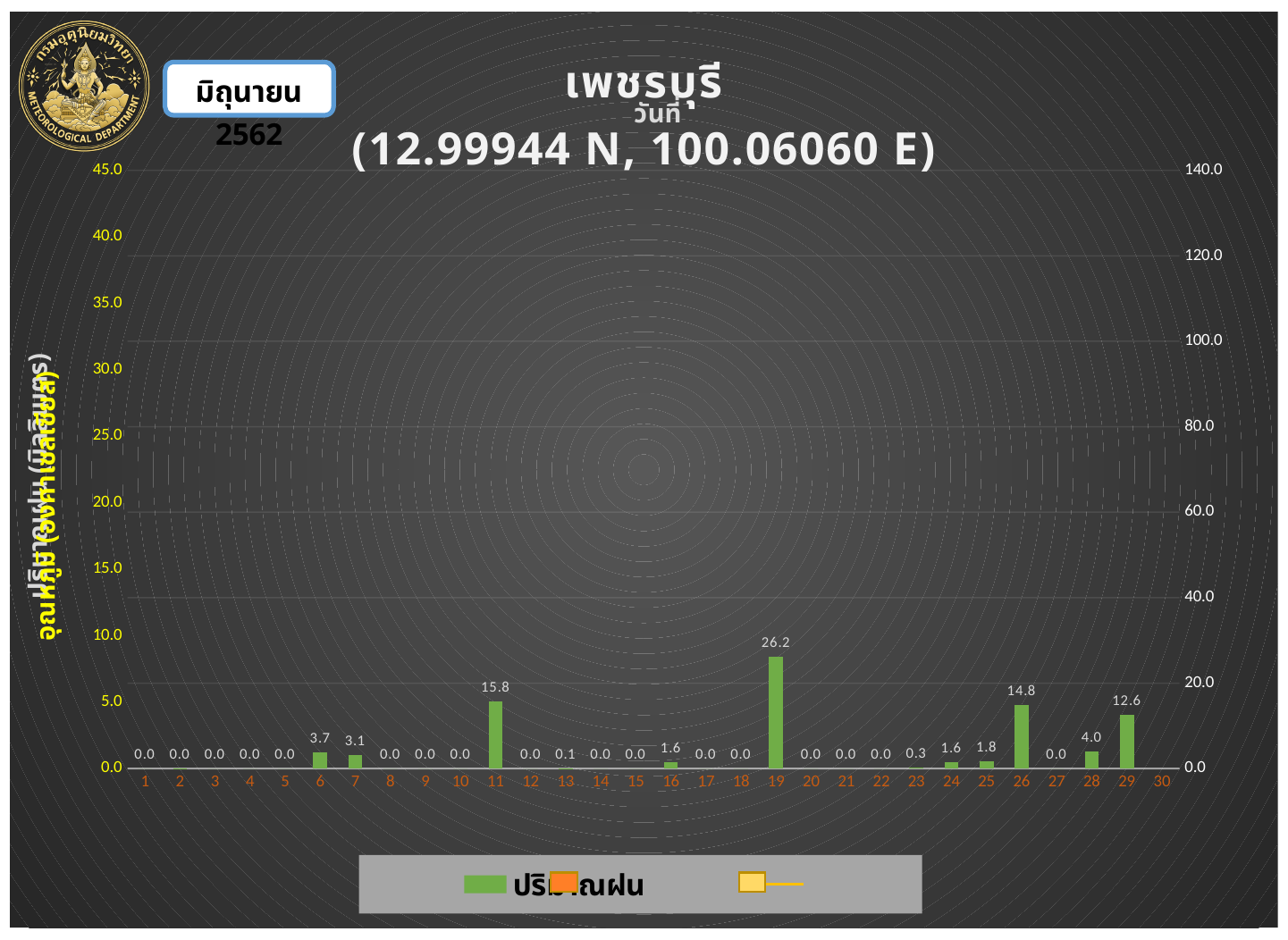
Which day has the larger rainfall value, day 6 or day 7? 6 How many days are shown on the x axis? 30 Which day has the highest rainfall value? 19 What is the rainfall value shown for day 11? 15.8 What is the difference between the rainfall values for day 19 and day 11? 10.4 What is the rainfall value shown for day 28? 4.0 Is the value for day 19 greater or less than 20.0 on the right axis? greater What is the rainfall value shown for day 26? 14.8 What kind of chart is shown on the slide? bar chart What is the rainfall value shown for day 29? 12.6 What is the difference between the rainfall values for day 26 and day 29? 2.2 What is the rainfall value shown for day 19? 26.2